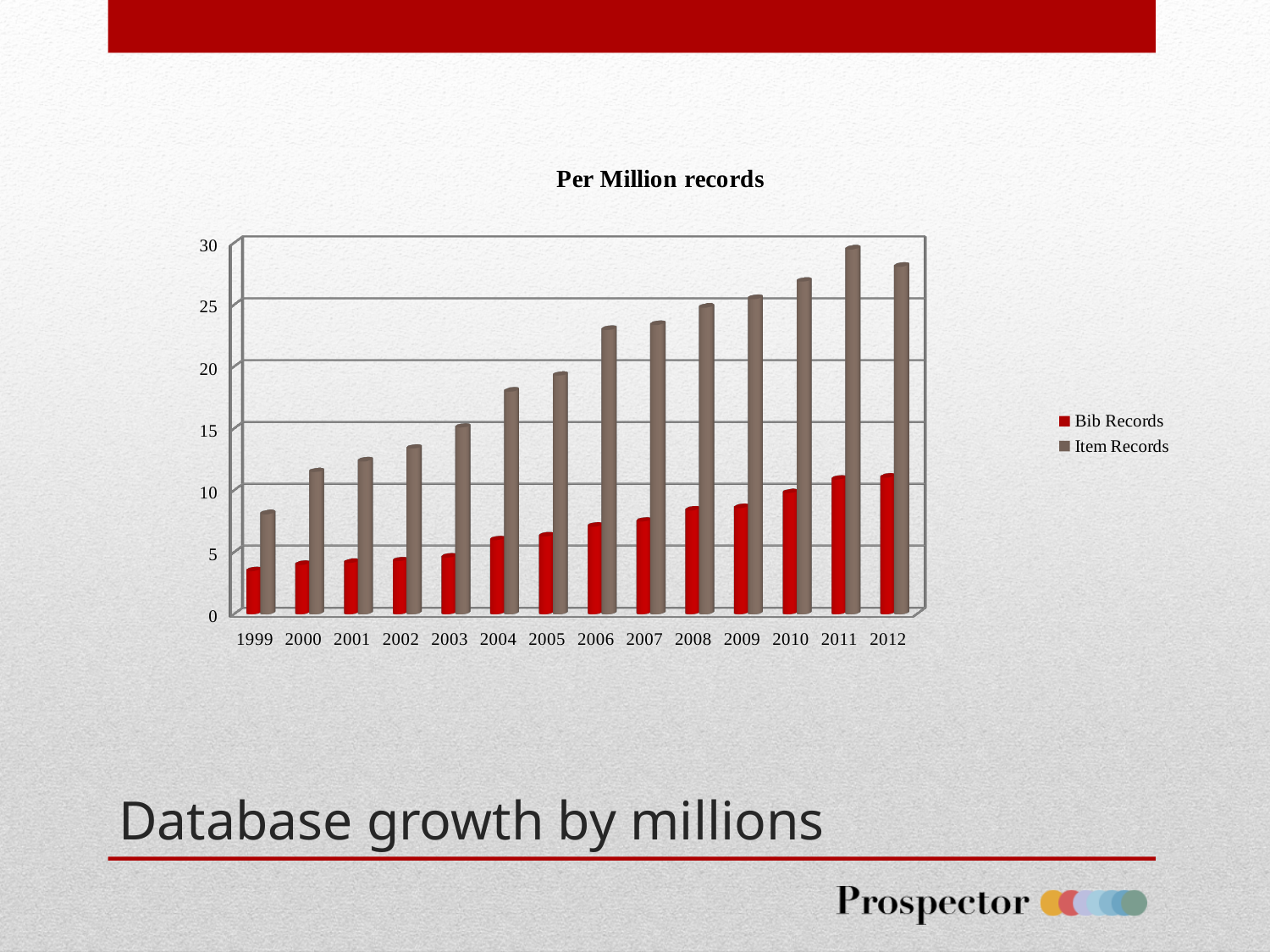
In which year are Bib Records lowest? 1999 In which year are Item Records lowest? 1999 Which is larger in 2012, Bib Records or Item Records? Item Records Is the value for Item Records in 2006 greater or less than 20? greater Which series is shown in red? Bib Records Is the value for Bib Records in 1999 greater or less than 5? less What is the title of the chart? Per Million records What kind of chart is shown on the slide? bar chart Do Bib Records generally rise or fall from 1999 to 2012? rise How many years are shown on the x axis? 14 In which year are Item Records highest? 2011 How many series does the legend list? 2